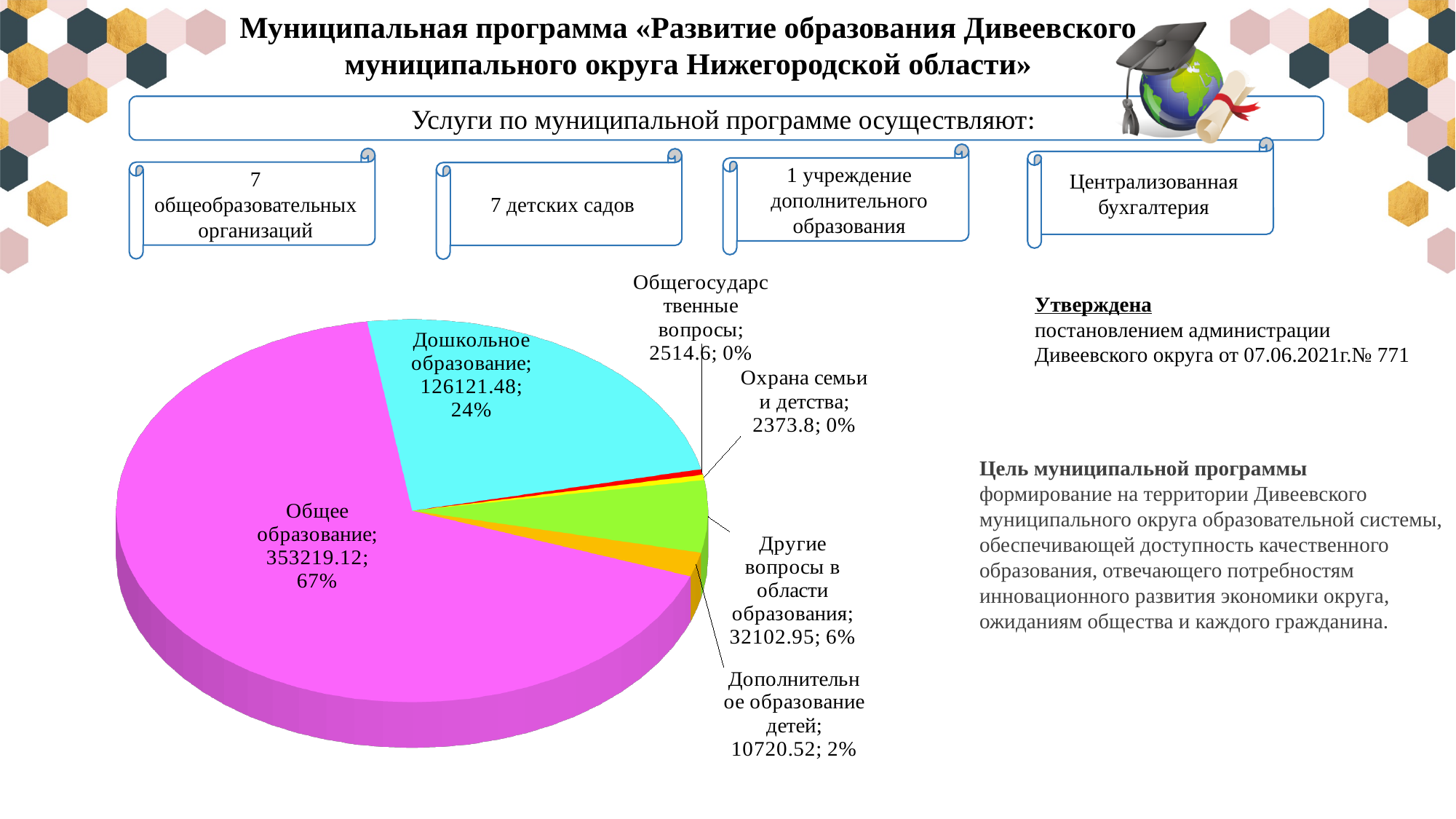
What is the value shown for the "Дополнительное образование детей" slice? 10720.52 What kind of chart is shown on the slide? Pie chart What is the difference between the values for "Общее образование" and "Дошкольное образование"? 227097.64 How many slices does the pie chart have? 6 Which is larger: the value for "Другие вопросы в области образования" or for "Дополнительное образование детей"? Другие вопросы в области образования Which category has the smallest value in the pie chart? Охрана семьи и детства Which category has the largest slice of the pie? Общее образование What is the value shown for the "Другие вопросы в области образования" slice? 32102.95 What share of the pie does "Дошкольное образование" represent? 24% What is the value shown for the "Охрана семьи и детства" slice? 2373.8 What is the value shown for the "Дошкольное образование" slice? 126121.48 What is the value shown for the "Общее образование" slice? 353219.12